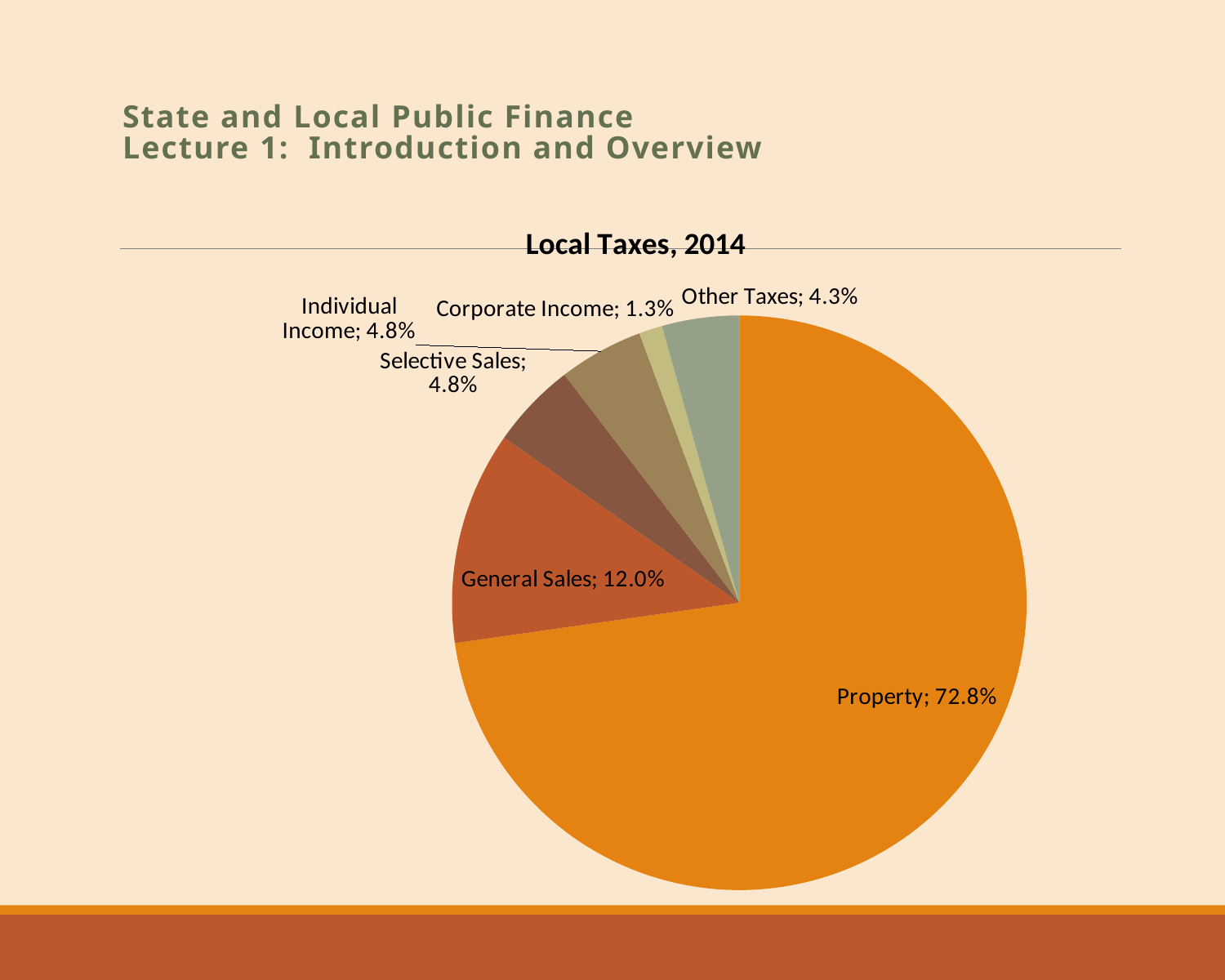
What share of local taxes comes from Corporate Income? 1.3% What share of local taxes comes from General Sales? 12.0% How many categories are shown in the pie chart? 6 What is the difference between the Property share and the General Sales share? 60.8% What share of local taxes comes from Property? 72.8% Which category has the largest share of local taxes? Property Which category has the smallest share of local taxes? Corporate Income What share of local taxes comes from Other Taxes? 4.3% What type of chart is shown on the slide? pie chart What is the title of the chart? Local Taxes, 2014 What is the combined share of Individual Income and Selective Sales? 9.6% Which is larger, the share for General Sales or the share for Other Taxes? General Sales